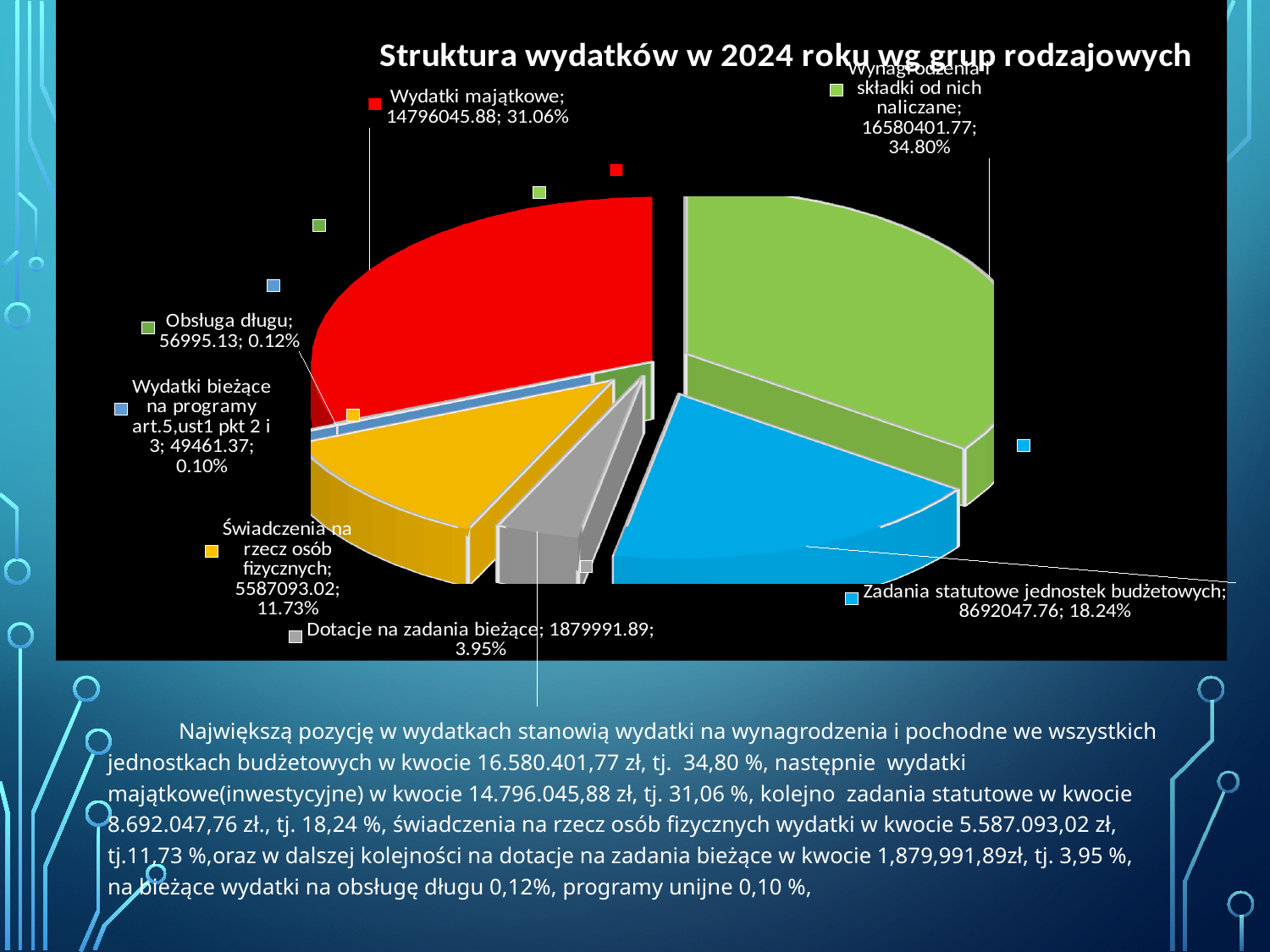
What share of the pie does Wynagrodzenia i składki od nich naliczane represent? 34.80% What percentage is shown for Dotacje na zadania bieżące? 3.95% What value is shown for Zadania statutowe jednostek budżetowych? 8692047.76 What is the difference in percentage points between Wynagrodzenia i składki od nich naliczane (34.80%) and Wydatki majątkowe (31.06%)? 3.74 What kind of chart is shown on the slide? pie chart Which is larger: Świadczenia na rzecz osób fizycznych or Dotacje na zadania bieżące? Świadczenia na rzecz osób fizycznych Which category has the smallest slice of the pie? Wydatki bieżące na programy art.5,ust1 pkt 2 i 3 Which category has the largest slice of the pie? Wynagrodzenia i składki od nich naliczane What value is shown for Wydatki majątkowe? 14796045.88 What is the title of the chart? Struktura wydatków w 2024 roku wg grup rodzajowych What value is shown for Obsługa długu? 56995.13 How many slices does the pie chart have? 7